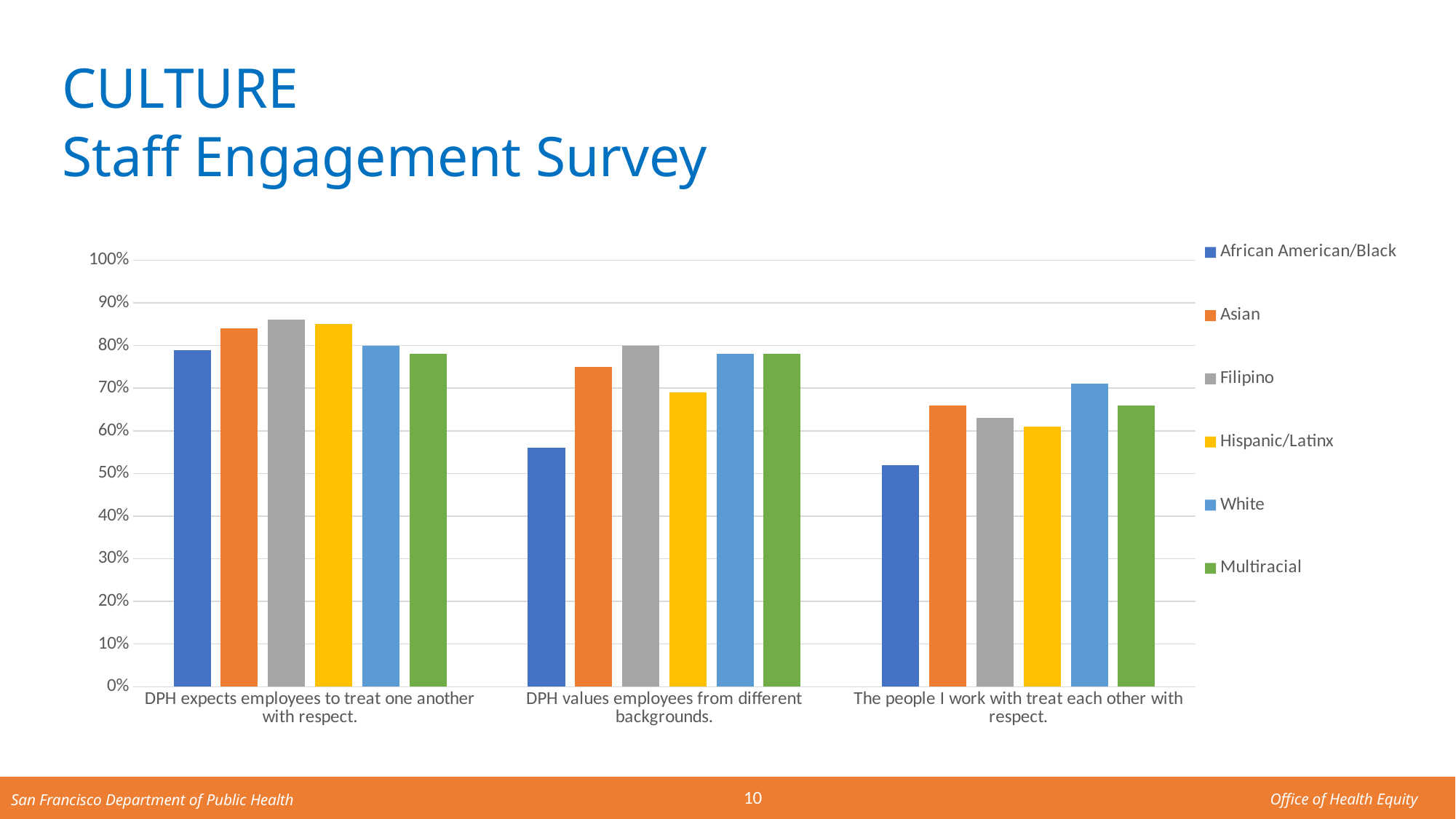
How many survey statements (categories) are shown on the x axis? 3 Is the value for Hispanic/Latinx on "The people I work with treat each other with respect." greater or less than 70%? less What kind of chart is shown on the slide? bar chart Do the values for African American/Black rise or fall moving left to right across the three statements? fall Which group has the highest value for "The people I work with treat each other with respect."? White How many series does the legend list? 6 Which group has the lowest value for "DPH values employees from different backgrounds."? African American/Black Is the value for Asian on "DPH expects employees to treat one another with respect." greater or less than 80%? greater Which legend entry is shown in green? Multiracial Which is larger for the Asian group: the value for "DPH expects employees to treat one another with respect." or for "The people I work with treat each other with respect."? DPH expects employees to treat one another with respect. Which group has the lowest value for "The people I work with treat each other with respect."? African American/Black Is the value for African American/Black on "DPH values employees from different backgrounds." greater or less than 60%? less